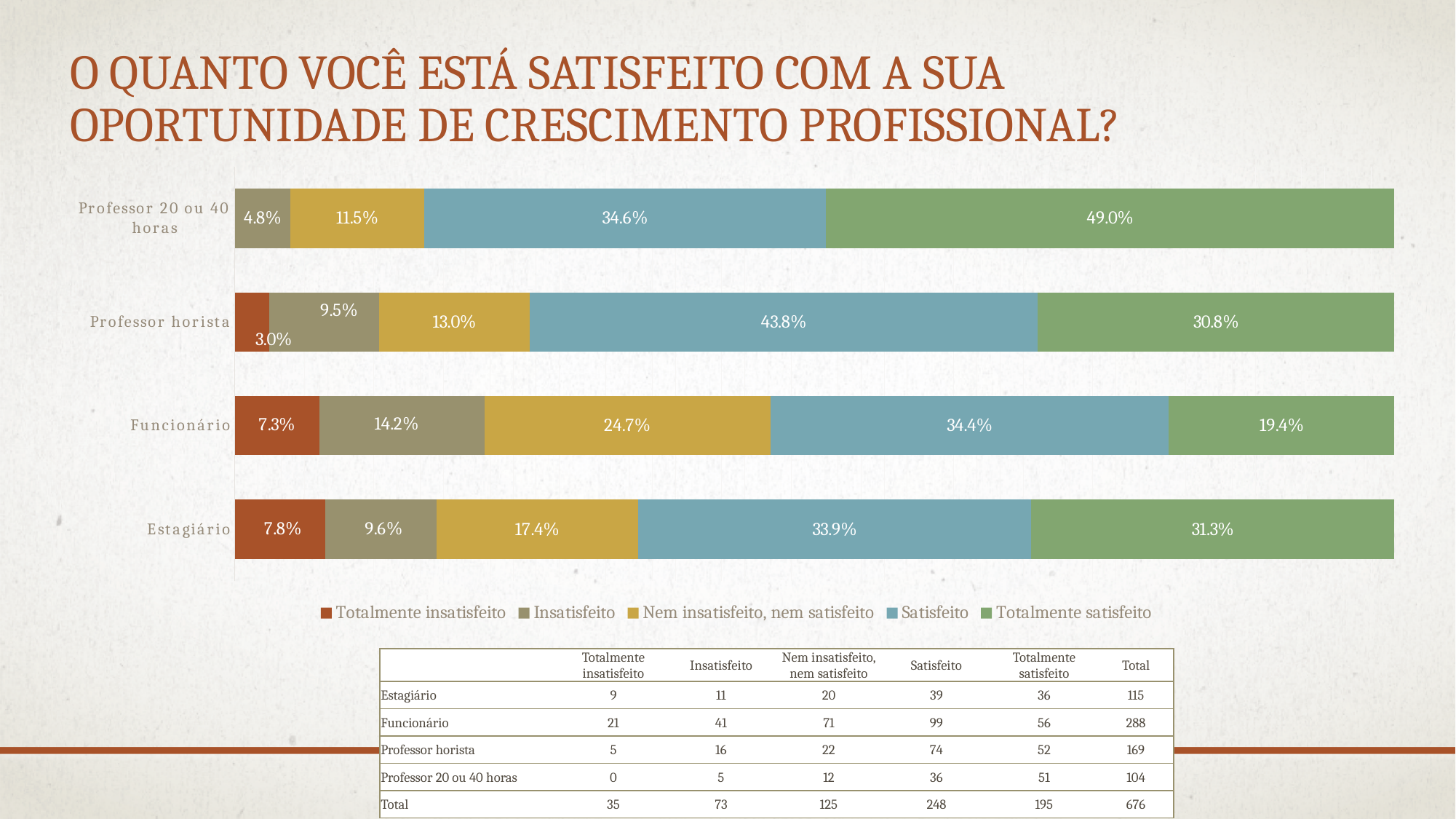
How many categories are shown on the chart? 4 What is the Nem insatisfeito, nem satisfeito value for Funcionário? 24.7% Which category has the lowest Totalmente satisfeito percentage? Funcionário How many series does the legend list? 5 Which category has the highest Totalmente satisfeito percentage? Professor 20 ou 40 horas Which is larger, the Satisfeito value for Funcionário or for Estagiário? Funcionário What percentage of Professor 20 ou 40 horas respondents are Totalmente satisfeito? 49.0% What is the Totalmente insatisfeito value for Estagiário? 7.8% What is the difference between the Nem insatisfeito, nem satisfeito values for Funcionário and Estagiário? 7.3 percentage points What is the Satisfeito value for Professor horista? 43.8% Which series is shown in green in the legend? Totalmente satisfeito What kind of chart is shown on the slide? Stacked bar chart